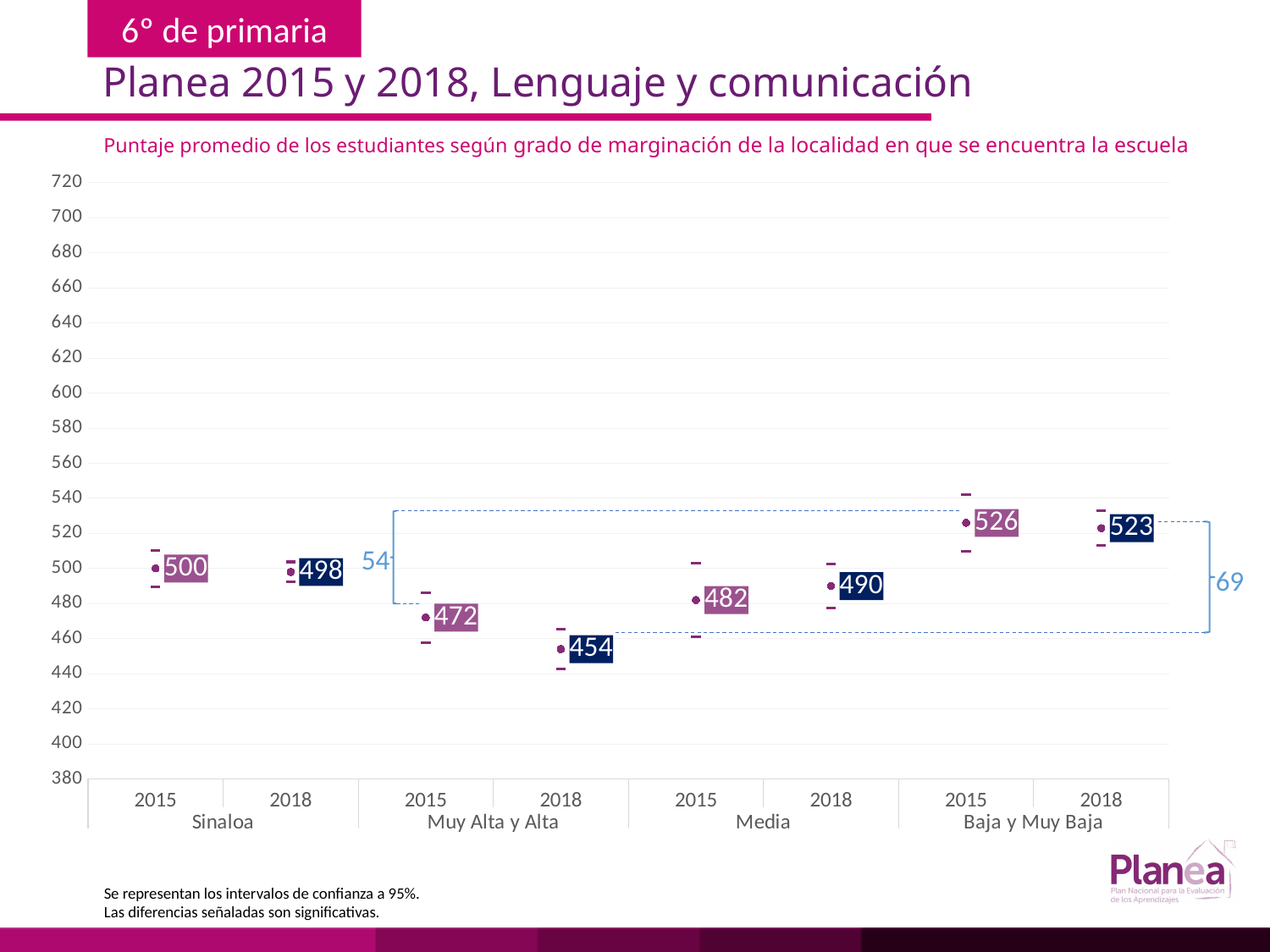
What is the subtitle of the chart? Puntaje promedio de los estudiantes según grado de marginación de la localidad en que se encuentra la escuela What is the average score for Baja y Muy Baja in 2015? 526 Is the 2018 score for Sinaloa greater or less than 500? less What is the average score for Media in 2018? 490 What is the average score for Muy Alta y Alta in 2018? 454 Which group and year has the lowest average score? Muy Alta y Alta, 2018 What is the average score for Sinaloa in 2015? 500 How many data points are plotted on the chart? 8 Which group and year has the highest average score? Baja y Muy Baja, 2015 What is the difference between the 2018 scores for Baja y Muy Baja and Media? 33 What is the difference between the 2015 and 2018 scores for Muy Alta y Alta? 18 Which is larger, the Media score in 2015 or in 2018? 2018